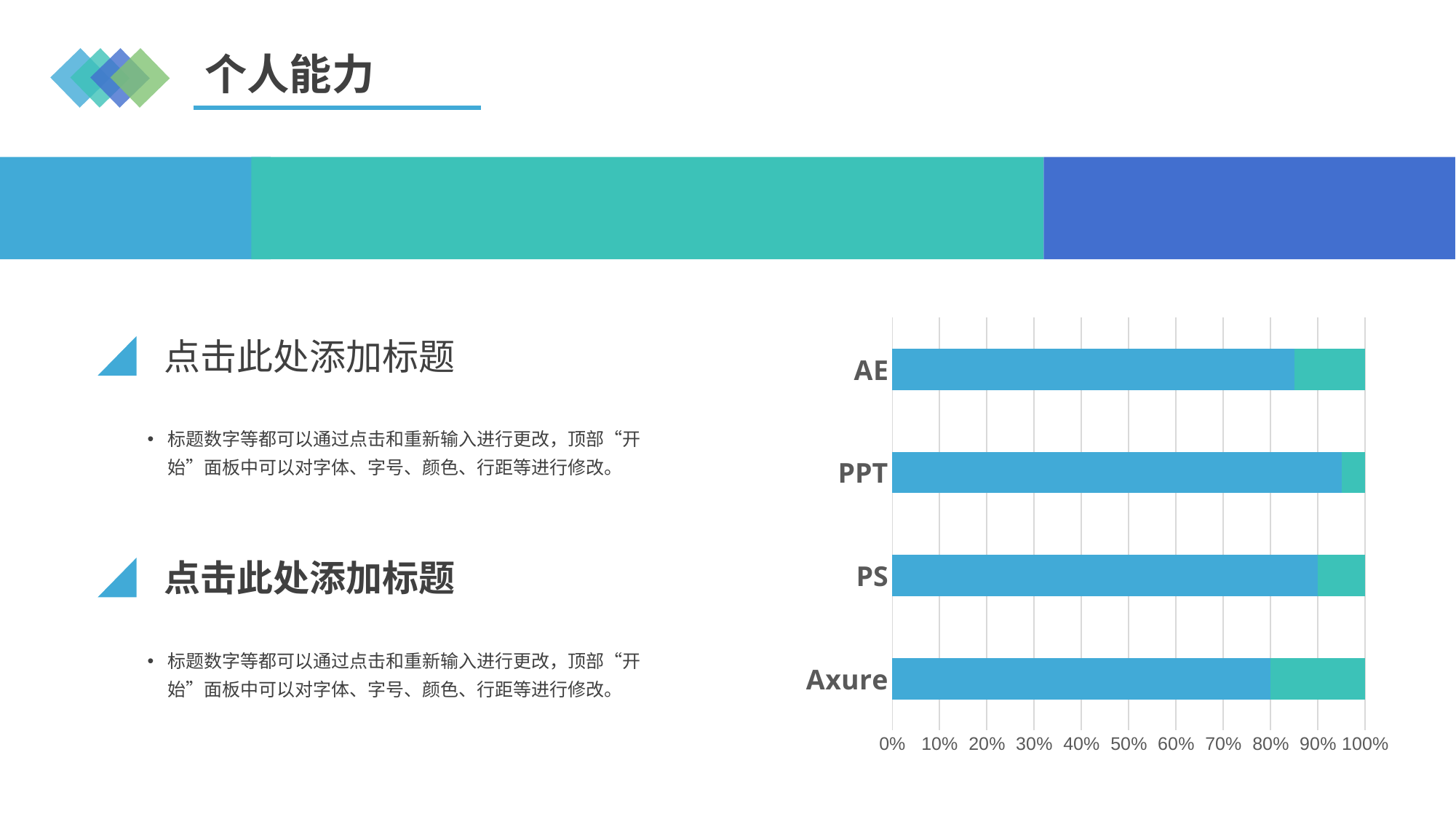
Which has the larger blue segment, AE or PS? PS Which category has the shortest blue segment in the bar chart? Axure What two colours are used for the segments in the bar chart? blue and green Which has the larger green segment, Axure or PPT? Axure Is the blue segment for AE greater or less than 80%? greater Is the blue segment for PPT greater or less than 90%? greater Is the blue segment for PS greater or less than 70%? greater What is the total length of the AE stacked bar on the axis? 100% How many categories does the bar chart show? 4 Which category has the longest blue segment in the bar chart? PPT What kind of chart is shown on the right of the slide? bar chart